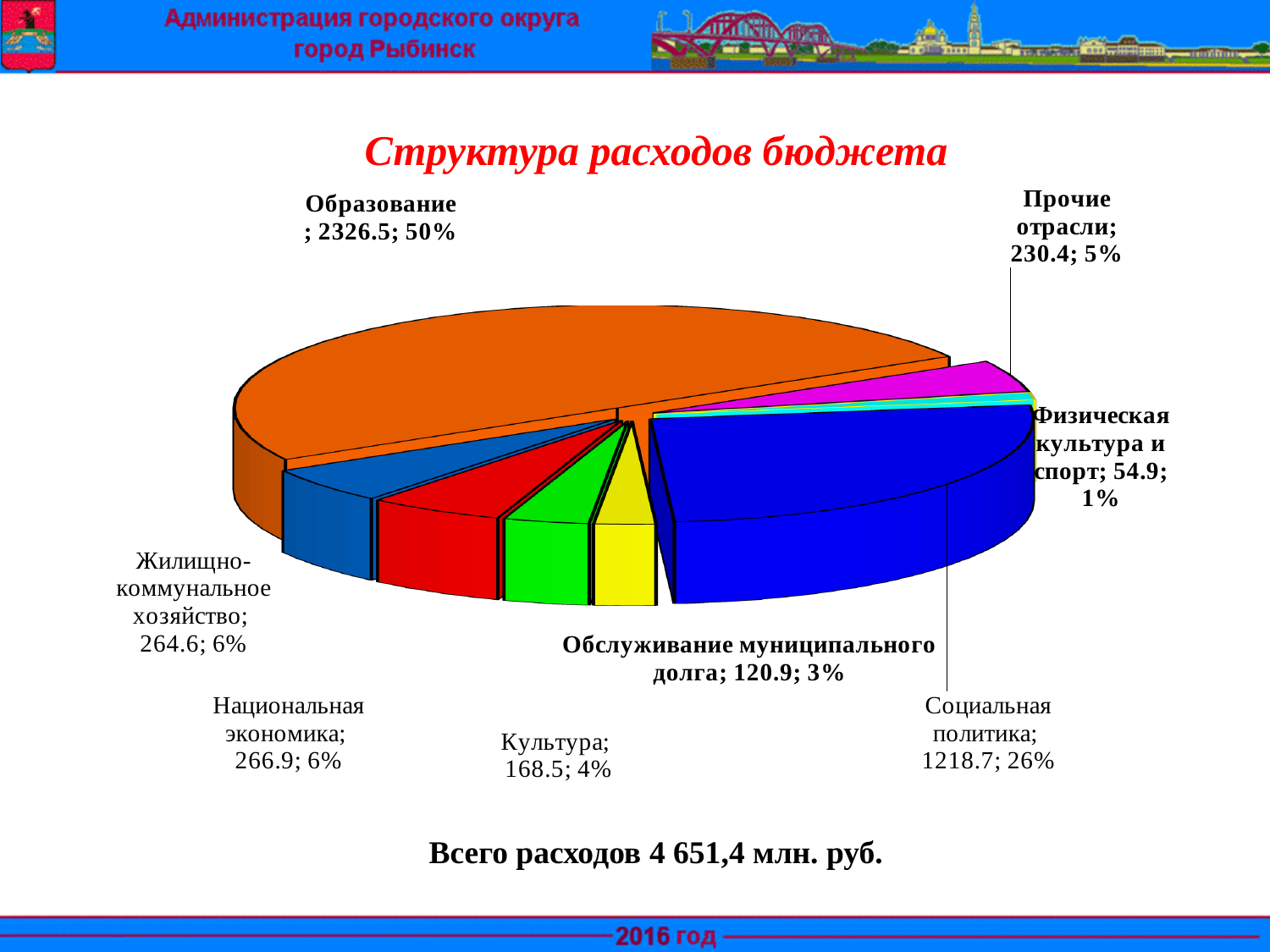
Which category has the largest slice of the pie? Образование Which is larger, the value for Национальная экономика or the value for Жилищно-коммунальное хозяйство? Национальная экономика What is the difference between the values for Образование and Социальная политика? 1107.8 What is the value for Образование? 2326.5 What is the value for Культура? 168.5 What is the title of the chart? Структура расходов бюджета What kind of chart is shown on the slide? pie chart Which category has the smallest slice of the pie? Физическая культура и спорт How many categories does the pie chart show? 8 What share of the pie does Прочие отрасли take? 5% What share of the pie does Социальная политика take? 26% What is the value for Обслуживание муниципального долга? 120.9